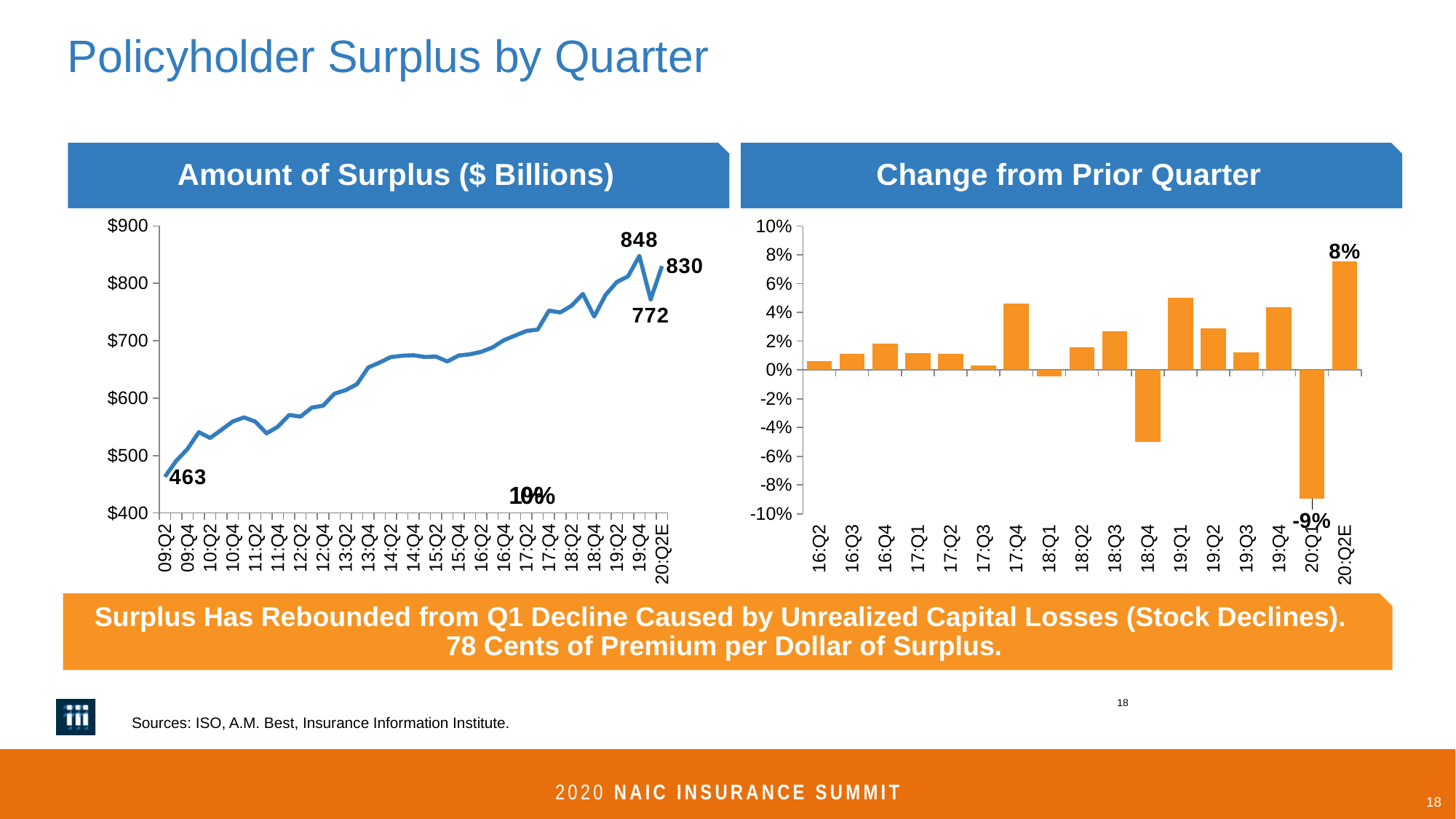
What kind of chart is the 'Change from Prior Quarter' chart? bar chart In the 'Amount of Surplus ($ Billions)' chart, what is the difference between the 19:Q4 value and the 20:Q1 value? 76 In the 'Change from Prior Quarter' chart, what is the value labeled for 20:Q2E? 8% In the 'Amount of Surplus ($ Billions)' chart, what is the value labeled for 20:Q1? 772 In the 'Amount of Surplus ($ Billions)' chart, what is the value labeled for 20:Q2E? 830 In the 'Amount of Surplus ($ Billions)' chart, which is larger, the value for 19:Q4 or the value for 20:Q2E? 19:Q4 In the 'Change from Prior Quarter' chart, how many quarters are shown on the x axis? 17 In the 'Change from Prior Quarter' chart, what is the value labeled for 20:Q1? -9% In the 'Amount of Surplus ($ Billions)' chart, what is the value labeled for 19:Q4? 848 In the 'Change from Prior Quarter' chart, which quarter has the lowest value? 20:Q1 What kind of chart is the 'Amount of Surplus ($ Billions)' chart? line chart In the 'Amount of Surplus ($ Billions)' chart, what is the value labeled at the start of the line, 09:Q2? 463